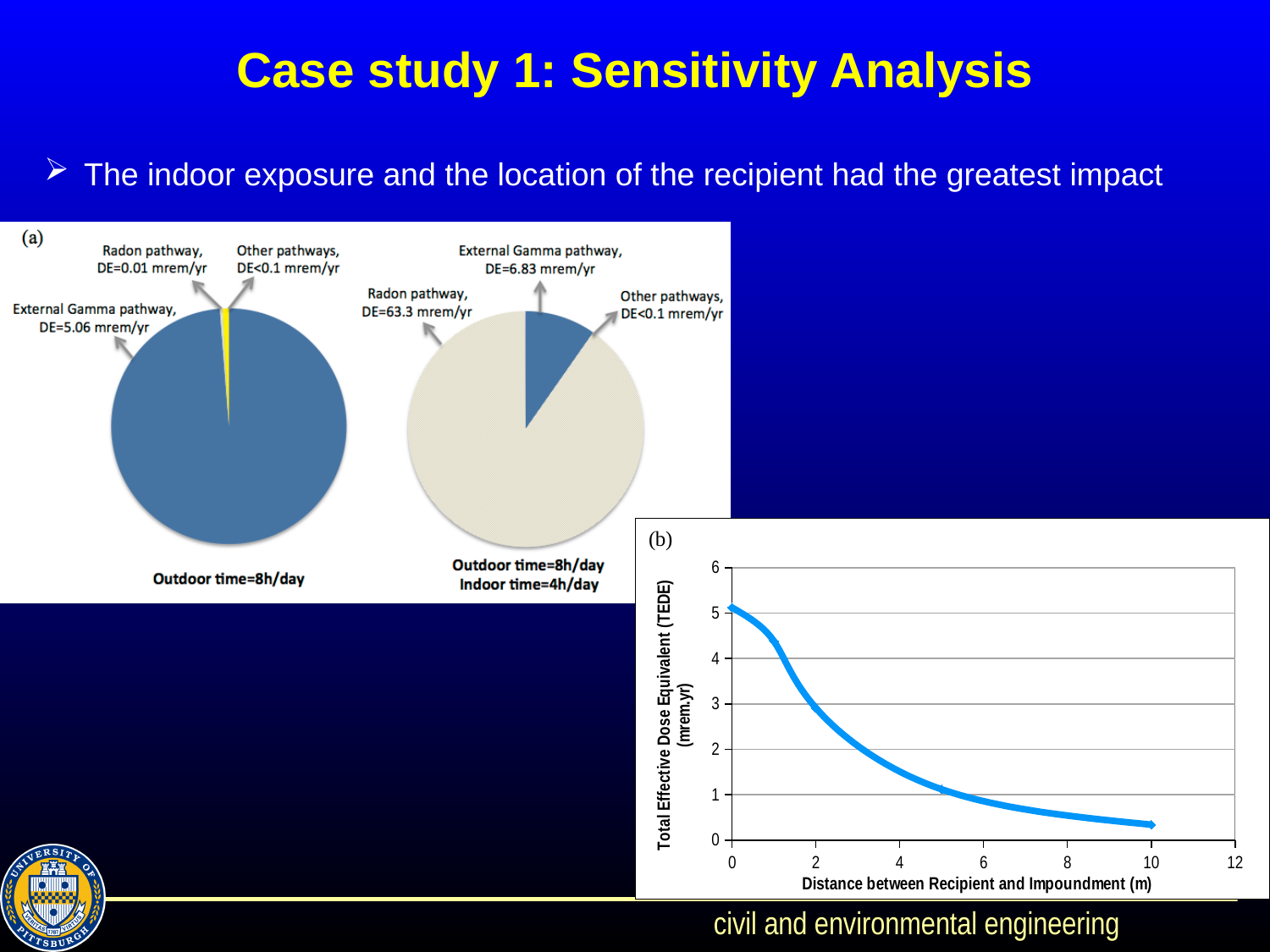
In panel (a), what is the difference between the External Gamma pathway dose equivalent in the right pie chart (6.83 mrem/yr) and in the left pie chart (5.06 mrem/yr)? 1.77 mrem/yr In the left pie chart of panel (a) (Outdoor time=8h/day), what is the dose equivalent for the Radon pathway? DE=0.01 mrem/yr In the right pie chart of panel (a) (Outdoor time=8h/day, Indoor time=4h/day), what is the dose equivalent for the External Gamma pathway? DE=6.83 mrem/yr In panel (a), is the External Gamma pathway dose equivalent larger in the left pie chart (Outdoor time=8h/day) or the right pie chart (Outdoor 8h/day, Indoor 4h/day)? The right pie chart In panel (b), is the Total Effective Dose Equivalent at a distance of 10 m greater or less than 1? less In the left pie chart of panel (a), which pathway has the largest slice? External Gamma pathway What kind of chart is panel (b)? Line chart In the left pie chart of panel (a) (Outdoor time=8h/day), what is the dose equivalent for the External Gamma pathway? DE=5.06 mrem/yr In the right pie chart of panel (a) (Outdoor time=8h/day, Indoor time=4h/day), what is the dose equivalent for the Radon pathway? DE=63.3 mrem/yr In panel (b), is the Total Effective Dose Equivalent at a distance of 0 m greater or less than 4? greater In the right pie chart of panel (a), which pathway has the largest slice? Radon pathway In panel (b), does the Total Effective Dose Equivalent rise or fall as the distance between recipient and impoundment increases? Fall